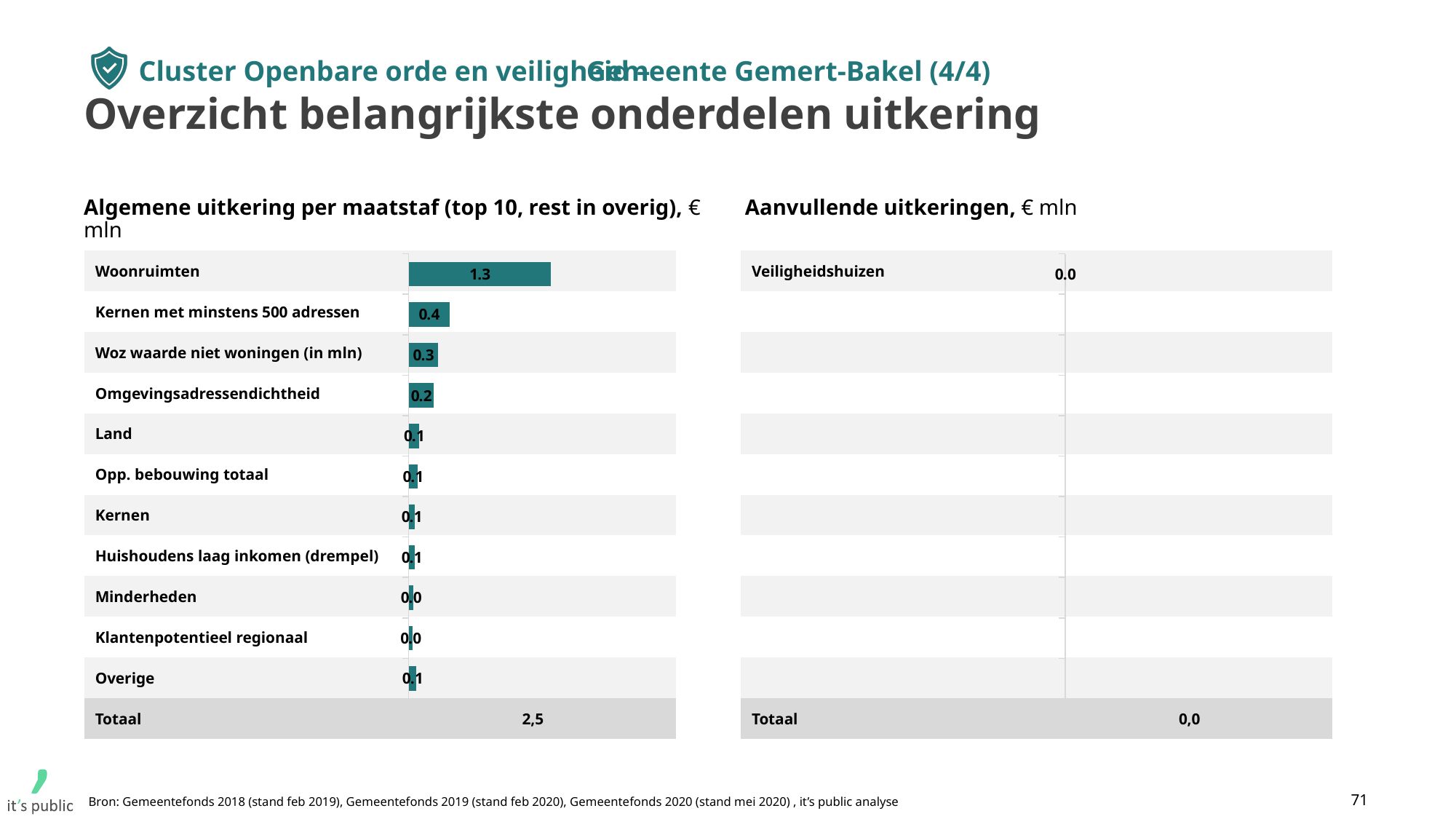
In the 'Algemene uitkering per maatstaf' chart, what is the value for Kernen met minstens 500 adressen? 0.4 In the 'Aanvullende uitkeringen' chart, what is the value for Veiligheidshuizen? 0.0 What is the Totaal shown for the 'Algemene uitkering per maatstaf' chart? 2,5 In the 'Algemene uitkering per maatstaf' chart, which is larger: Woz waarde niet woningen (in mln) or Omgevingsadressendichtheid? Woz waarde niet woningen (in mln) In the 'Algemene uitkering per maatstaf' chart, what is the value for Woonruimten? 1.3 In the 'Algemene uitkering per maatstaf' chart, which category has the highest value? Woonruimten In the 'Algemene uitkering per maatstaf' chart, what is the value for Woz waarde niet woningen (in mln)? 0.3 In the 'Algemene uitkering per maatstaf' chart, what is the value for Omgevingsadressendichtheid? 0.2 What kind of chart is the 'Algemene uitkering per maatstaf' chart? Bar chart What is the Totaal shown for the 'Aanvullende uitkeringen' chart? 0,0 How many categories (excluding the Totaal row) are shown in the 'Algemene uitkering per maatstaf' chart? 11 In the 'Algemene uitkering per maatstaf' chart, what is the difference between Woonruimten and Kernen met minstens 500 adressen? 0.9